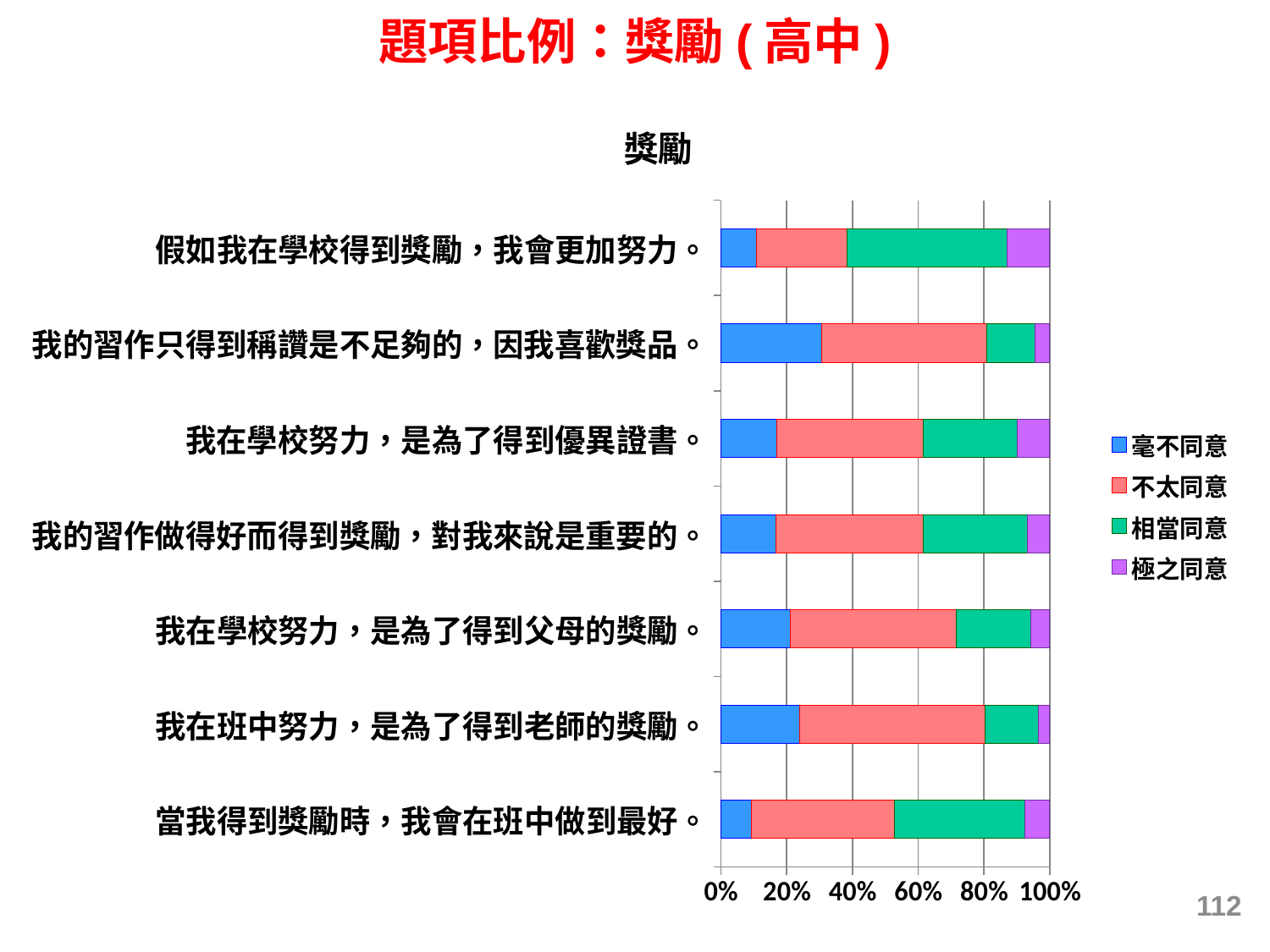
Which legend entry is shown in red/pink? 不太同意 What kind of chart is shown on the slide? Stacked bar chart Is the 毫不同意 share for "我的習作只得到稱讚是不足夠的，因我喜歡獎品。" greater or less than 20%? greater Which statement has the largest 毫不同意 segment? 我的習作只得到稱讚是不足夠的，因我喜歡獎品。 What is the title of the chart? 獎勵 How many statements (categories) are plotted in the chart? 7 Is the 毫不同意 share for "假如我在學校得到獎勵，我會更加努力。" greater or less than 20%? less Is the 相當同意 share for "假如我在學校得到獎勵，我會更加努力。" greater or less than 40%? greater Which has the larger 毫不同意 segment: "我的習作只得到稱讚是不足夠的，因我喜歡獎品。" or "假如我在學校得到獎勵，我會更加努力。"? 我的習作只得到稱讚是不足夠的，因我喜歡獎品。 How many series does the legend list? 4 Which statement has the largest 相當同意 segment? 假如我在學校得到獎勵，我會更加努力。 Which has the larger 相當同意 segment: "假如我在學校得到獎勵，我會更加努力。" or "我在班中努力，是為了得到老師的獎勵。"? 假如我在學校得到獎勵，我會更加努力。